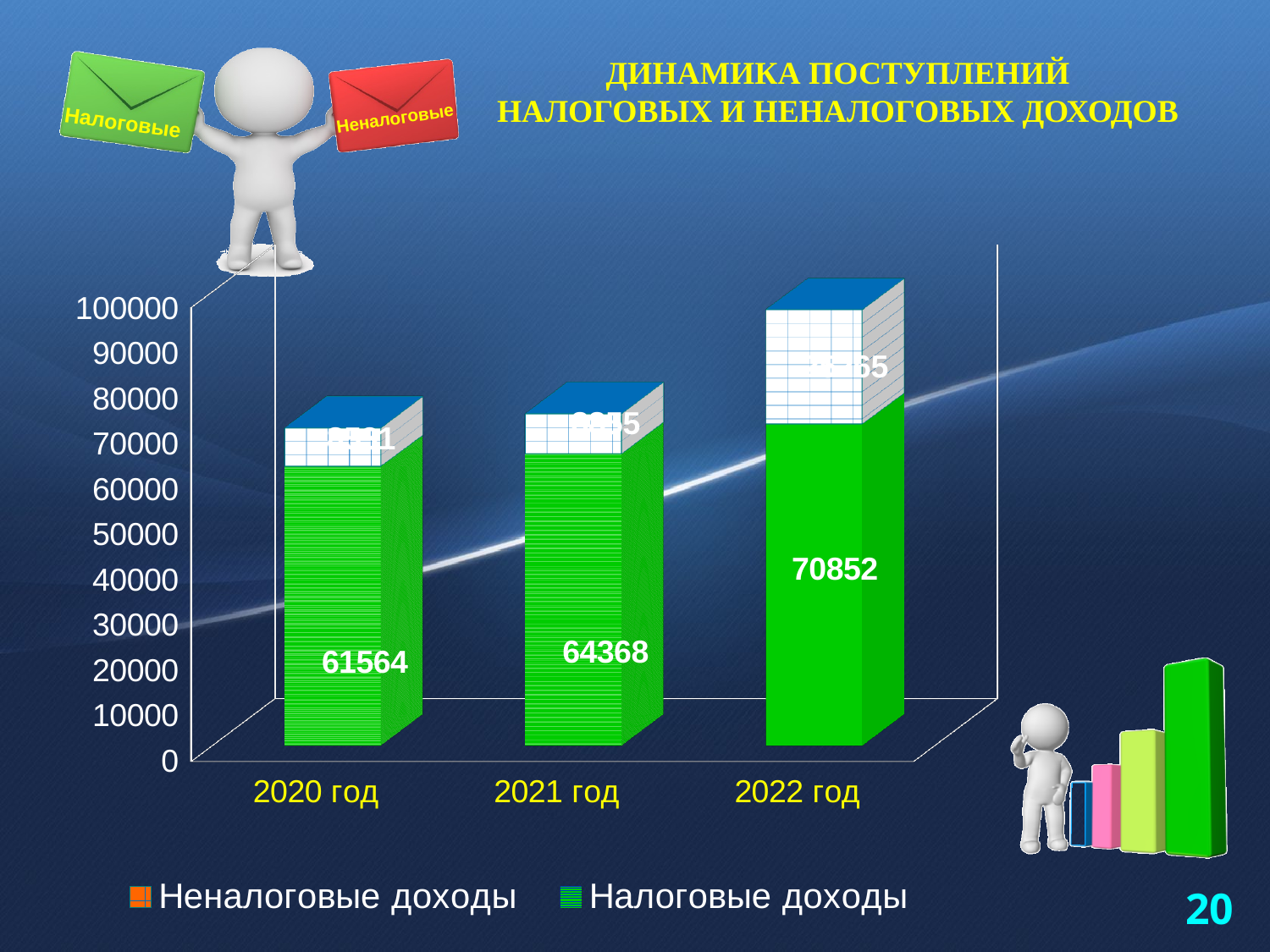
Do the values of Налоговые доходы rise or fall from 2020 год to 2022 год? rise Which year has the larger value of Налоговые доходы, 2021 год or 2022 год? 2022 год By how much did Налоговые доходы increase from 2020 год to 2022 год? 9288 What is the value of Налоговые доходы for 2020 год? 61564 What is the value of Налоговые доходы for 2021 год? 64368 In which year is the value of Налоговые доходы the highest? 2022 год What is the value of Налоговые доходы for 2022 год? 70852 How many years are shown on the x axis of the chart? 3 How many series does the chart legend list? 2 In which year is the value of Налоговые доходы the lowest? 2020 год What is the difference in Налоговые доходы between 2021 год and 2020 год? 2804 Is the total height of the stacked bar for 2022 год greater or less than 90000? greater